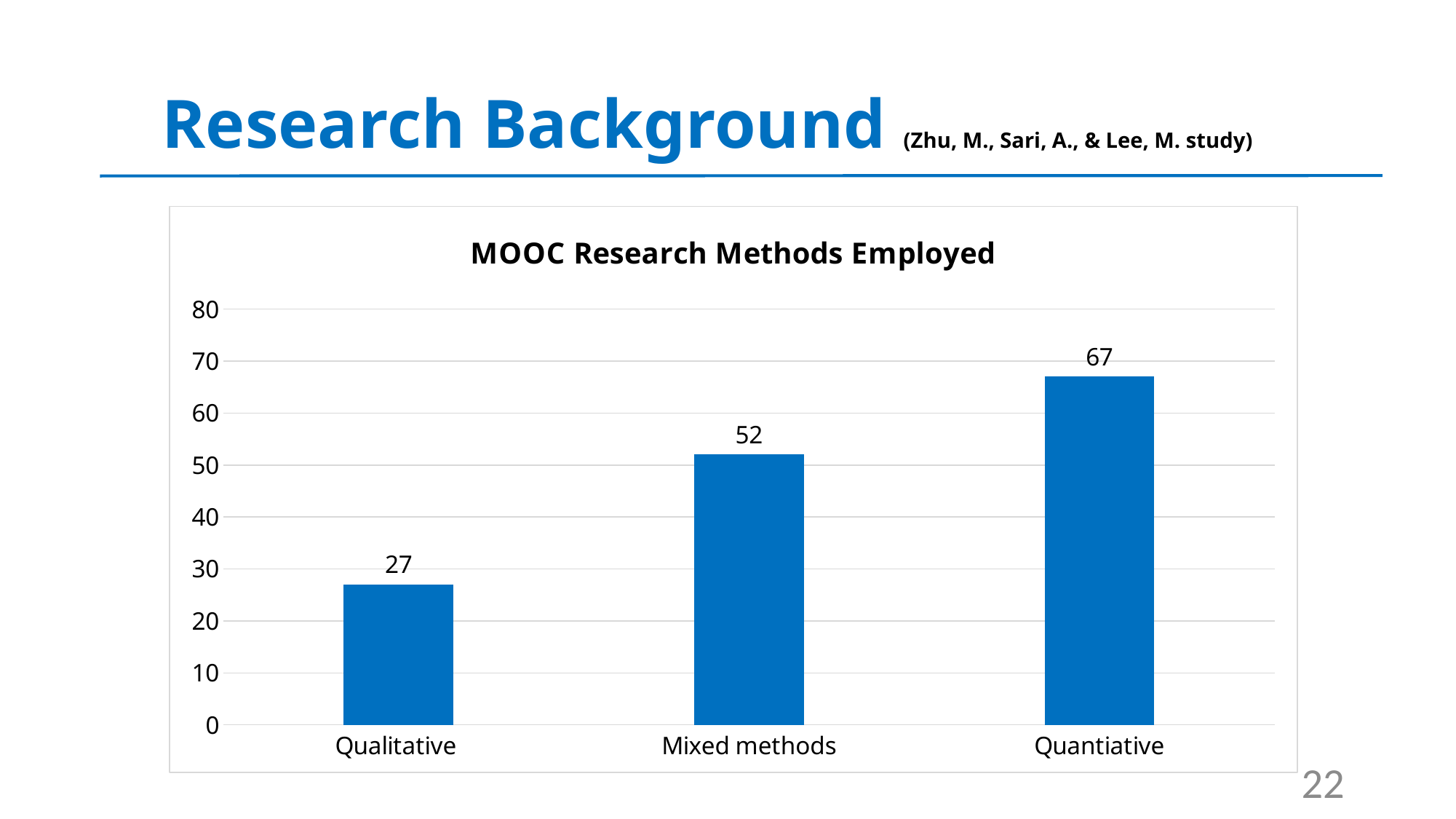
What is the value for Mixed methods? 52 Is the value for Mixed methods greater or less than 40? greater What is the title of the chart? MOOC Research Methods Employed Which category has the lowest value? Qualitative Which is larger, the value for Mixed methods or the value for Quantiative? Quantiative Which category has the highest value? Quantiative What is the difference between the values for Mixed methods and Qualitative? 25 What is the value for Quantiative? 67 How many categories are shown on the x axis? 3 What is the value for Qualitative? 27 What kind of chart is shown on the slide? bar chart What is the difference between the values for Quantiative and Qualitative? 40